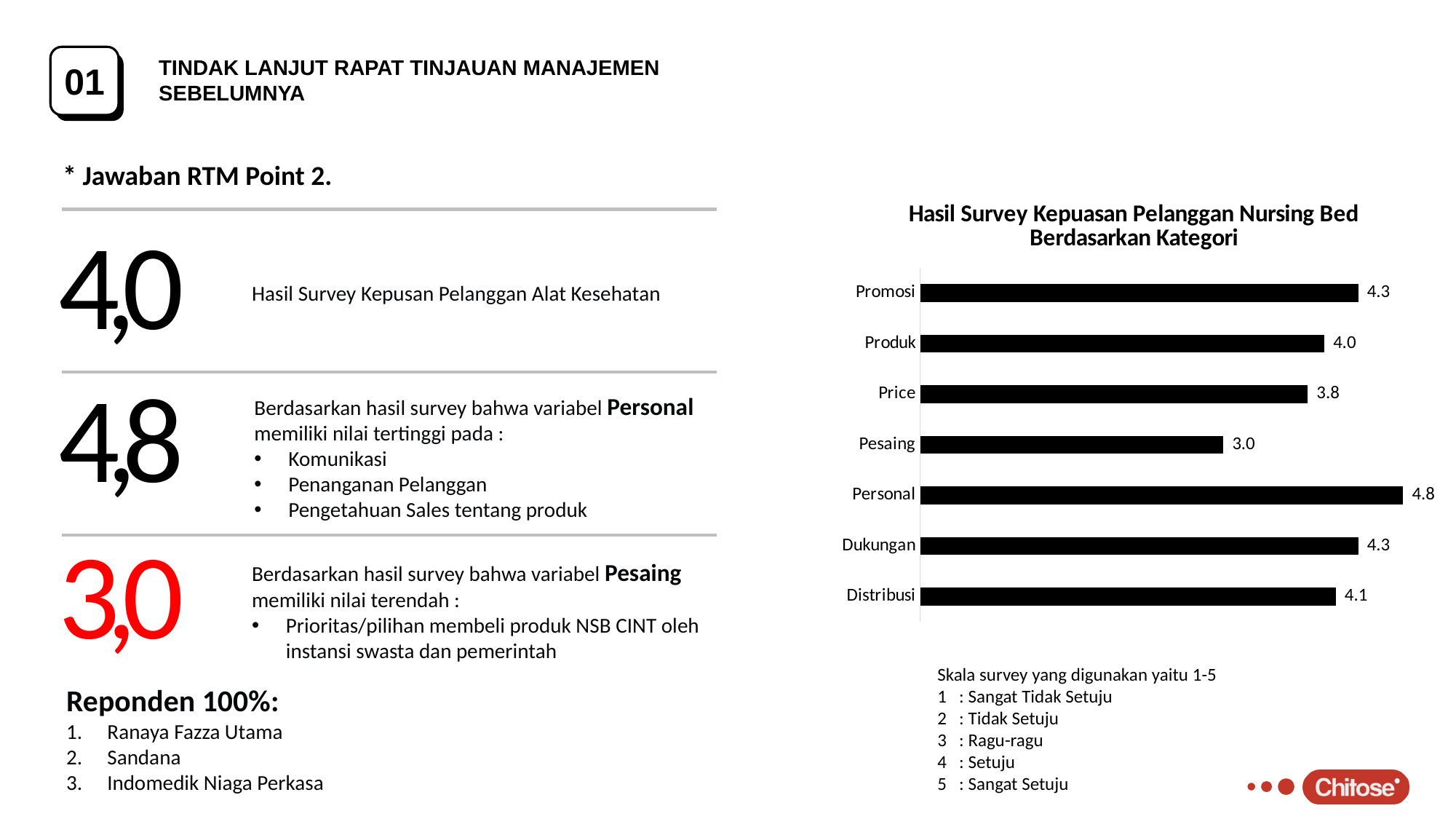
How many categories are shown in the chart? 7 Which category has the lowest value in the chart? Pesaing What is the difference between the values for Produk and Price? 0.2 What is the difference between the values for Personal and Pesaing? 1.8 What is the value for Dukungan in the chart? 4.3 What kind of chart is shown on the slide? Bar chart What is the value for Distribusi in the chart? 4.1 What is the value for Promosi in the chart? 4.3 Which has a larger value, Price or Distribusi? Distribusi What is the title of the chart? Hasil Survey Kepuasan Pelanggan Nursing Bed Berdasarkan Kategori What is the value for Pesaing in the chart? 3.0 Which category has the highest value in the chart? Personal